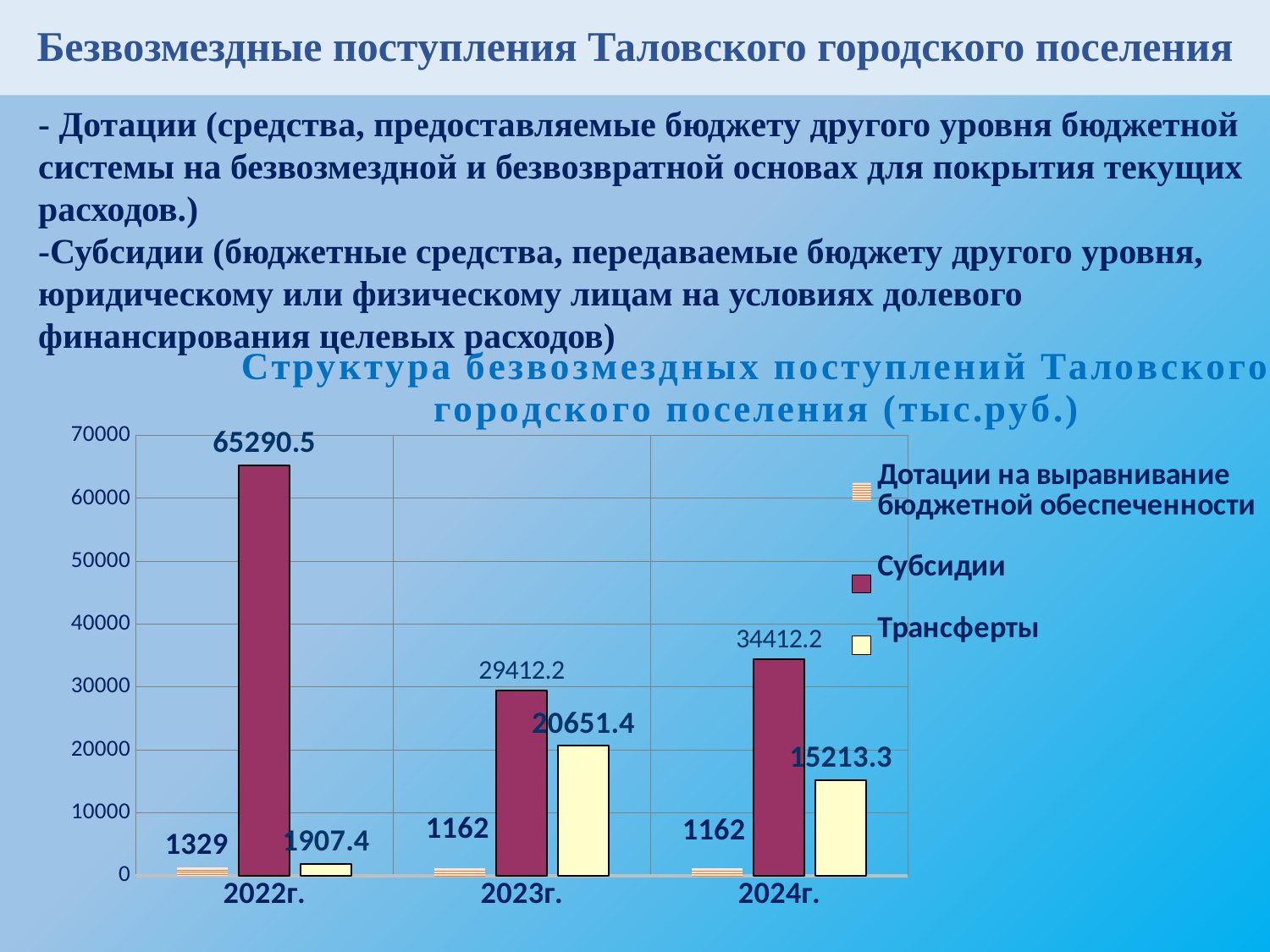
What type of chart is shown on the slide? Bar chart What is the value of Субсидии for 2022г.? 65290.5 Which is larger in 2023г.: Субсидии or Трансферты? Субсидии What is the value of Трансферты for 2023г.? 20651.4 What unit is given in the chart title? тыс.руб. What is the difference between the Субсидии values for 2024г. and 2023г.? 5000 How many year categories are shown on the x axis? 3 In which year is the Субсидии value highest? 2022г. How many series does the legend list? 3 What is the value of Дотации на выравнивание бюджетной обеспеченности for 2024г.? 1162 Does the Субсидии value for 2022г. rise or fall from 2022г. to 2023г.? Fall In which year is the Трансферты value lowest? 2022г.